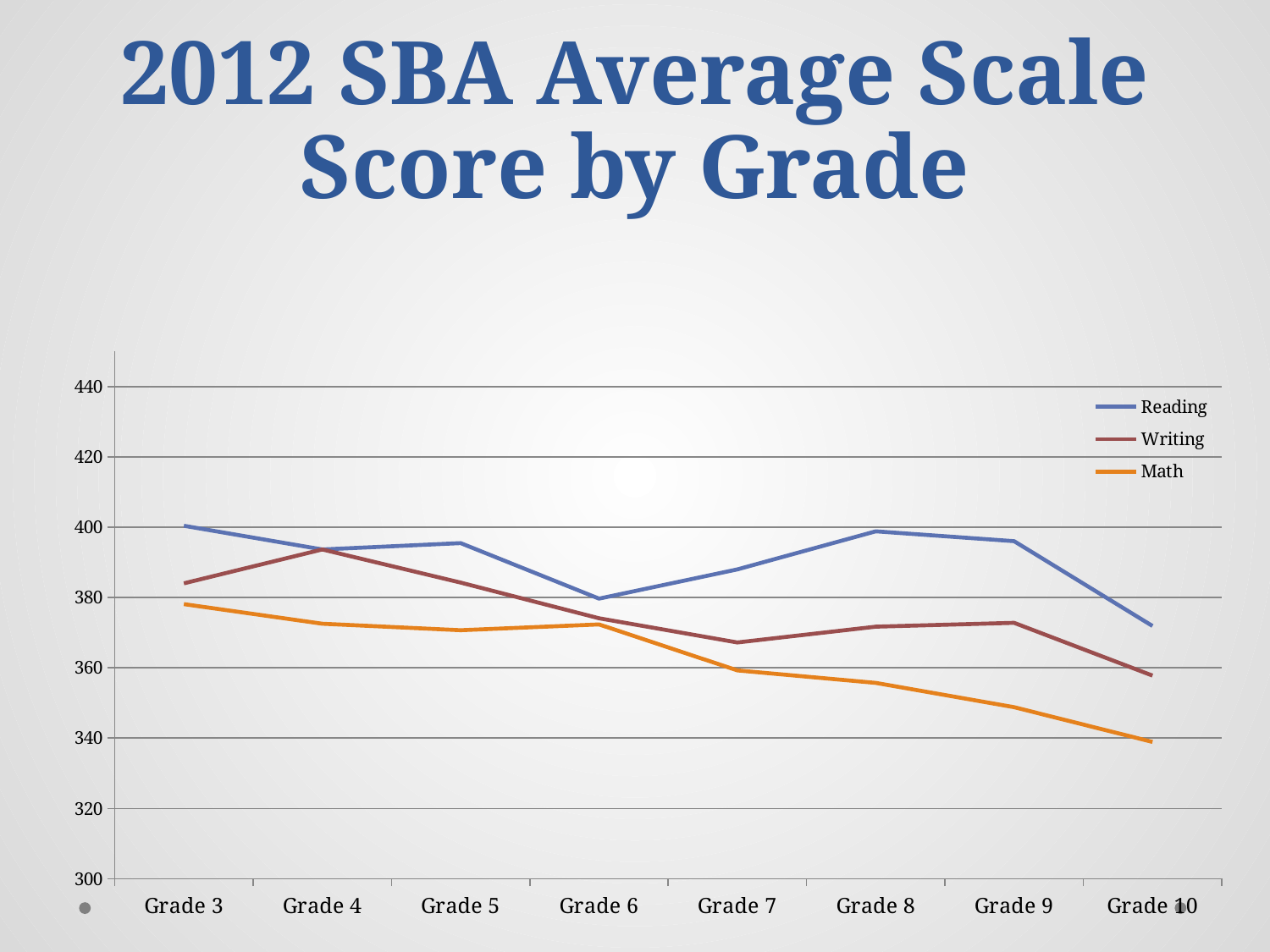
How many series does the legend list? 3 At which grade is the Math score highest? Grade 3 Is the Math value for Grade 9 greater or less than 360? less At which grade is the Writing score highest? Grade 4 At which grade is the Reading score lowest? Grade 10 At which grade is the Math score lowest? Grade 10 Does the Math line generally rise or fall from Grade 3 to Grade 10? fall How many grade categories are shown on the x axis? 8 What kind of chart is shown on the slide? line chart At Grade 10, which is larger, the Writing score or the Math score? Writing What is the title of the slide's chart? 2012 SBA Average Scale Score by Grade Which series is shown in orange in the legend? Math